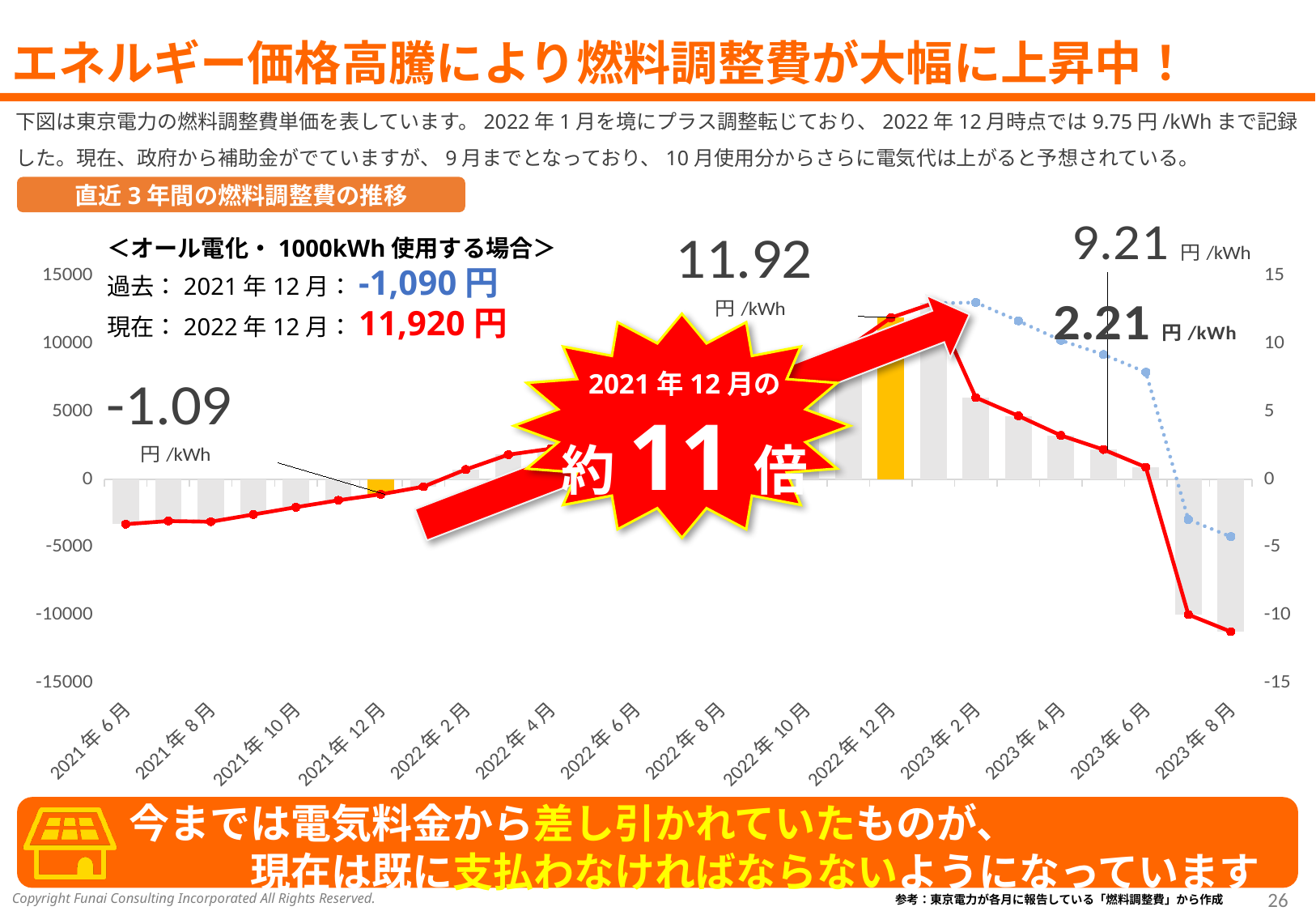
Is the value of the red line for 2022年6月 greater or less than 5 on the right axis? less What kind of chart is used to show the fuel adjustment cost trend? bar and line chart Which is larger, the value for 2021年12月 or the value for 2022年12月? 2022年12月 Does the red line rise or fall from 2021年6月 to 2022年12月? rise What is the title shown above the chart? 直近3年間の燃料調整費の推移 What is the labelled value for 2021年12月 on the chart? -1.09 円/kWh According to the callout on the chart, the 2022年12月 value is about how many times the 2021年12月 value? 約11倍 What is the difference between the labelled values for 2022年12月 (11.92 円/kWh) and 2021年12月 (-1.09 円/kWh)? 13.01 円/kWh What is the labelled value for 2022年12月 on the chart? 11.92 円/kWh Is the value of the red line for 2023年8月 greater or less than -10 on the right axis? less According to the text box on the chart, what is the fuel adjustment cost for 2022年12月 when using 1000kWh with all-electric? 11,920円